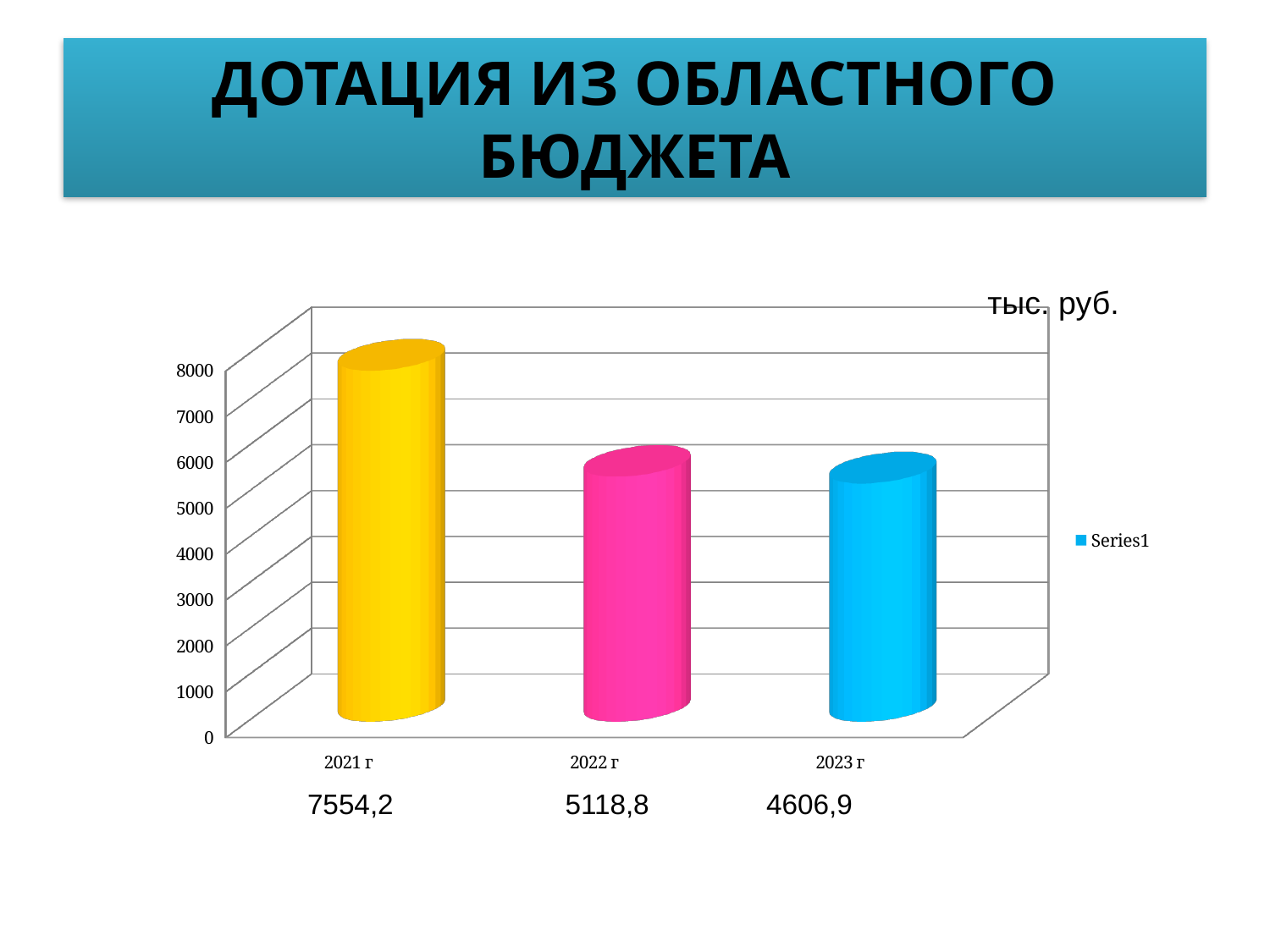
What is the difference between the values for 2022 г and 2023 г? 511,9 What is the value for 2021 г? 7554,2 Which year has the lowest value? 2023 г Is the value for 2021 г greater or less than 7000? greater Do the values rise or fall from 2021 г to 2023 г? fall How many years are shown on the chart? 3 Which is larger, the value for 2021 г or the value for 2023 г? 2021 г What kind of chart is shown on the slide? bar chart What is the difference between the values for 2021 г and 2022 г? 2435,4 Which year has the highest value? 2021 г What is the value for 2023 г? 4606,9 What is the value for 2022 г? 5118,8